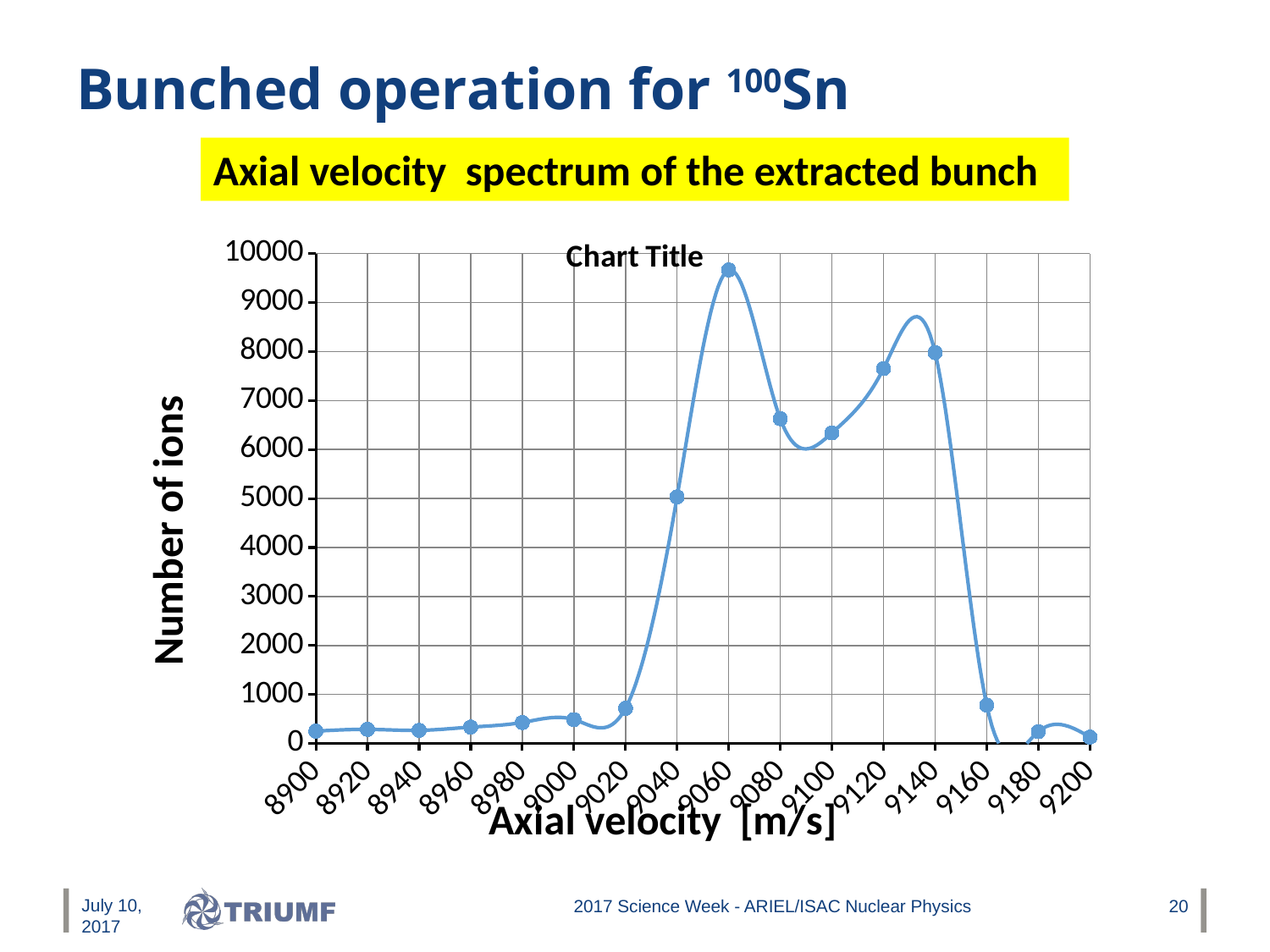
Is the number of ions at 9160 m/s greater or less than 1000? less Do the values rise or fall along the x axis from 8900 to 9060 m/s? rise Is the number of ions at 9120 m/s greater or less than 7000? greater Is the number of ions at 9040 m/s greater or less than 4000? greater What is the label of the vertical axis? Number of ions How many data points are plotted on the line? 16 At which axial velocity is the number of ions highest? 9060 Which has more ions, 9060 m/s or 9140 m/s? 9060 m/s Which has more ions, 9040 m/s or 9080 m/s? 9080 m/s What kind of chart is shown on the slide? line chart